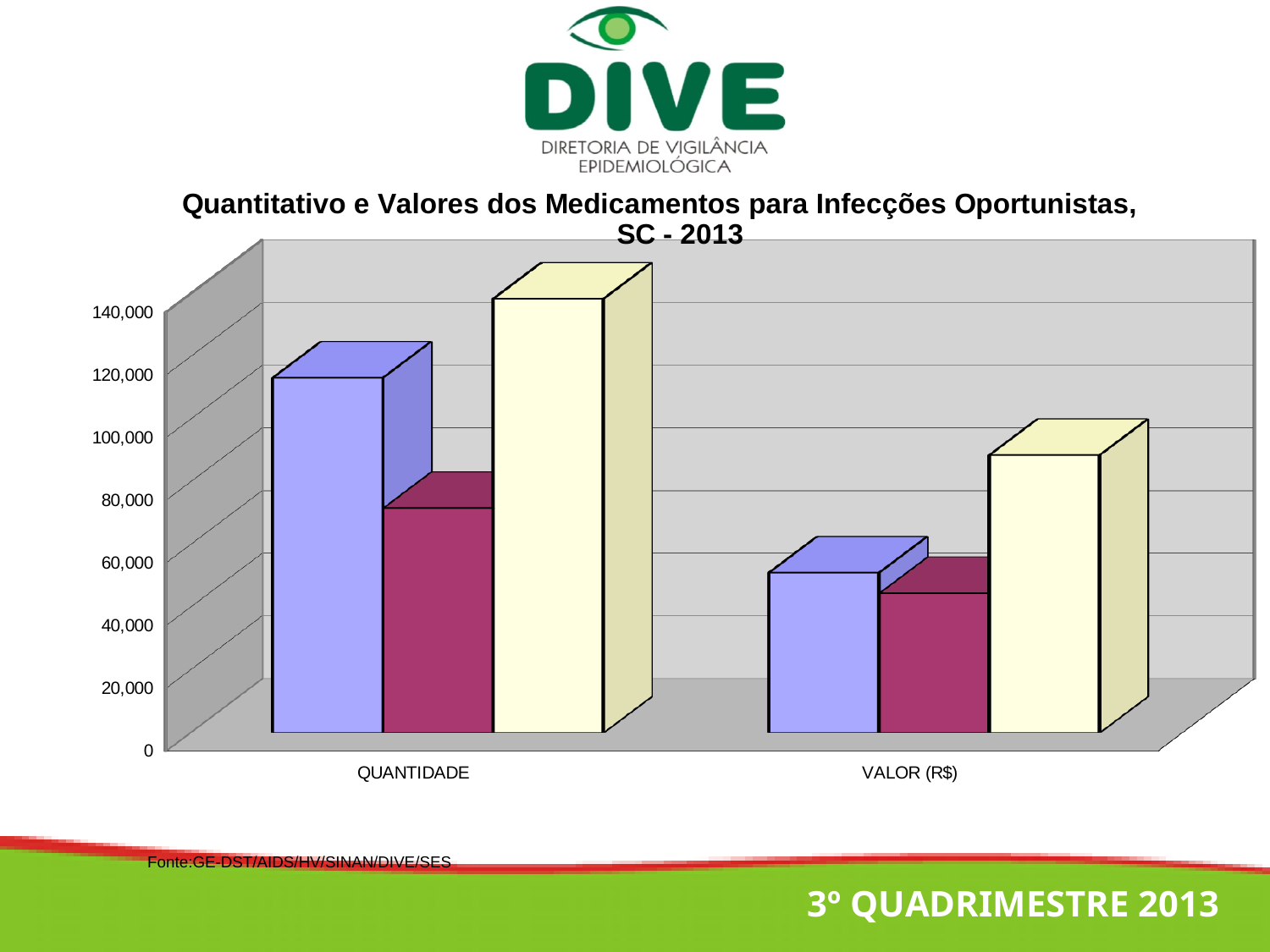
Is the value of the dark pink bar for QUANTIDADE greater or less than 100,000? less What kind of chart is shown on the slide? bar chart What is the title of the chart? Quantitativo e Valores dos Medicamentos para Infecções Oportunistas, SC - 2013 Is the value of the pale yellow bar for QUANTIDADE greater or less than 120,000? greater Is the value of the dark pink bar for VALOR (R$) greater or less than 60,000? less How many categories are shown on the x axis of the chart? 2 Which bar is the tallest in the QUANTIDADE category? the pale yellow bar Is the pale yellow bar larger for QUANTIDADE or for VALOR (R$)? QUANTIDADE Which bar is the shortest in the VALOR (R$) category? the dark pink bar How many bars are plotted for the QUANTIDADE category? 3